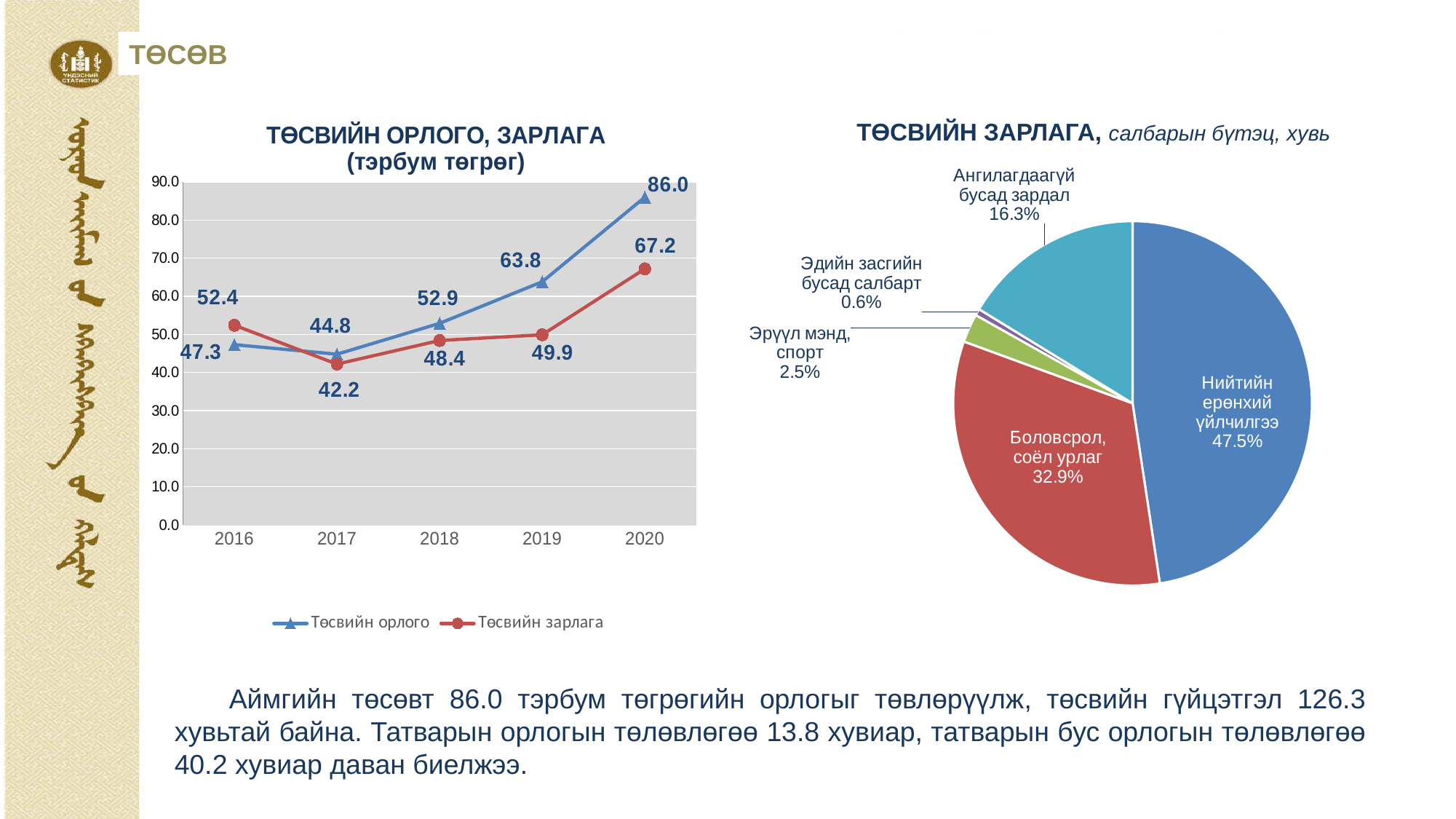
What kind of chart is the one titled 'ТӨСВИЙН ЗАРЛАГА, салбарын бүтэц, хувь'? pie chart In the chart titled 'ТӨСВИЙН ОРЛОГО, ЗАРЛАГА', which is larger in 2016, Төсвийн орлого or Төсвийн зарлага? Төсвийн зарлага In the chart titled 'ТӨСВИЙН ОРЛОГО, ЗАРЛАГА', what is the value of Төсвийн зарлага in 2017? 42.2 In the pie chart titled 'ТӨСВИЙН ЗАРЛАГА', which category has the largest share? Нийтийн ерөнхий үйлчилгээ In the chart titled 'ТӨСВИЙН ОРЛОГО, ЗАРЛАГА', in which year is Төсвийн орлого lowest? 2017 In the pie chart titled 'ТӨСВИЙН ЗАРЛАГА', what share does 'Боловсрол, соёл урлаг' have? 32.9% In the chart titled 'ТӨСВИЙН ОРЛОГО, ЗАРЛАГА', how many years are shown on the x axis? 5 In the chart titled 'ТӨСВИЙН ОРЛОГО, ЗАРЛАГА', what is the value of Төсвийн орлого in 2020? 86.0 In the pie chart titled 'ТӨСВИЙН ЗАРЛАГА', how many slices are there? 5 In the chart titled 'ТӨСВИЙН ОРЛОГО, ЗАРЛАГА', does Төсвийн орлого rise or fall from 2017 to 2020? rise In the chart titled 'ТӨСВИЙН ОРЛОГО, ЗАРЛАГА', what is the difference between Төсвийн орлого and Төсвийн зарлага in 2020? 18.8 In the chart titled 'ТӨСВИЙН ОРЛОГО, ЗАРЛАГА', how many series does the legend list? 2